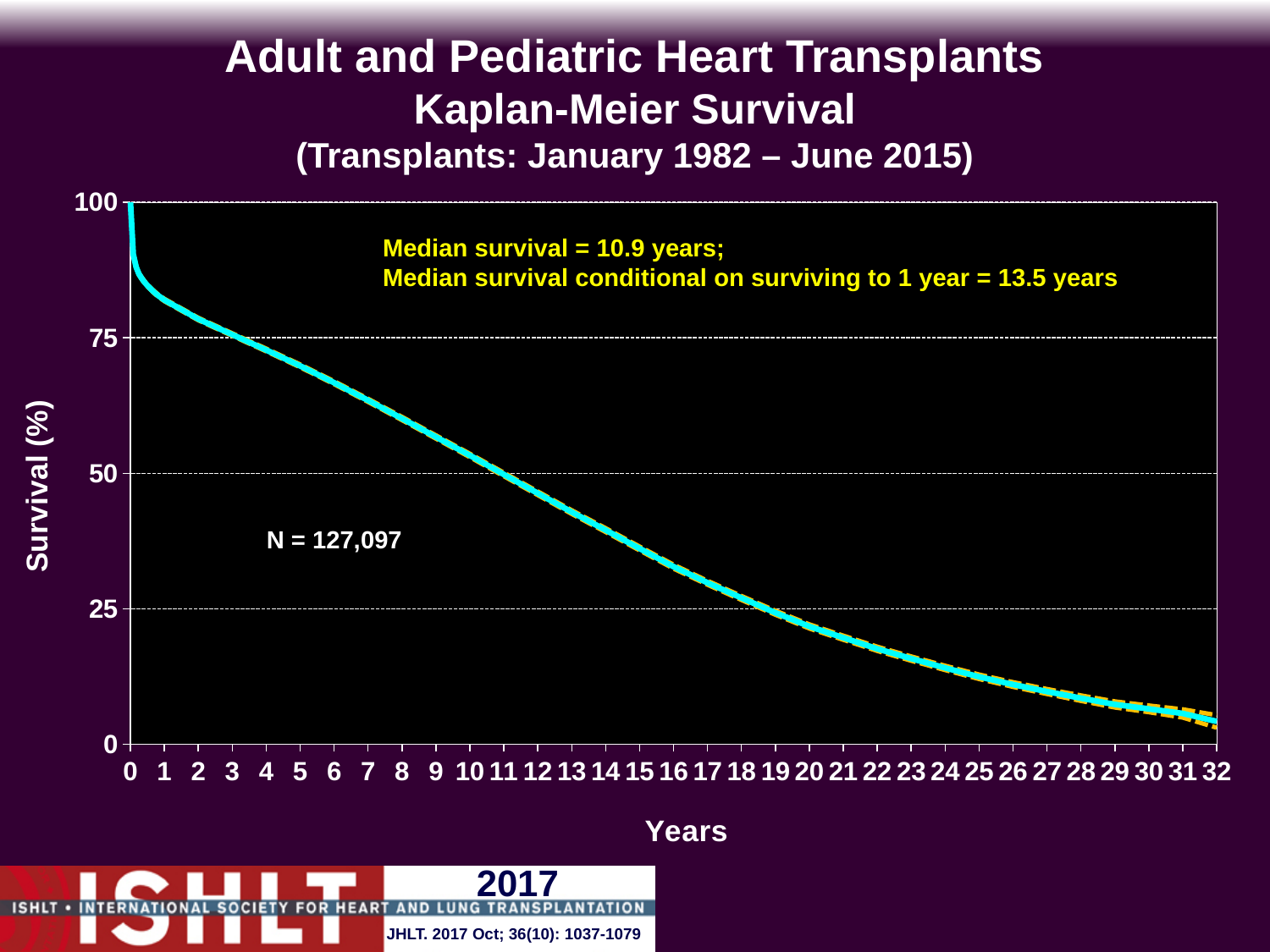
What is the largest value shown on the x axis (Years)? 32 What is the median survival conditional on surviving to 1 year, as stated on the chart? 13.5 years Is the survival value at 1 year greater or less than 75? greater Is the survival value at 30 years greater or less than 25? less What kind of chart is shown on the slide? line chart What is the value of N shown on the chart? 127,097 What is the median survival stated on the chart? 10.9 years What is the label of the y axis? Survival (%) Is the survival value at 5 years greater or less than 50? greater Does the survival curve rise or fall as the number of years increases? fall